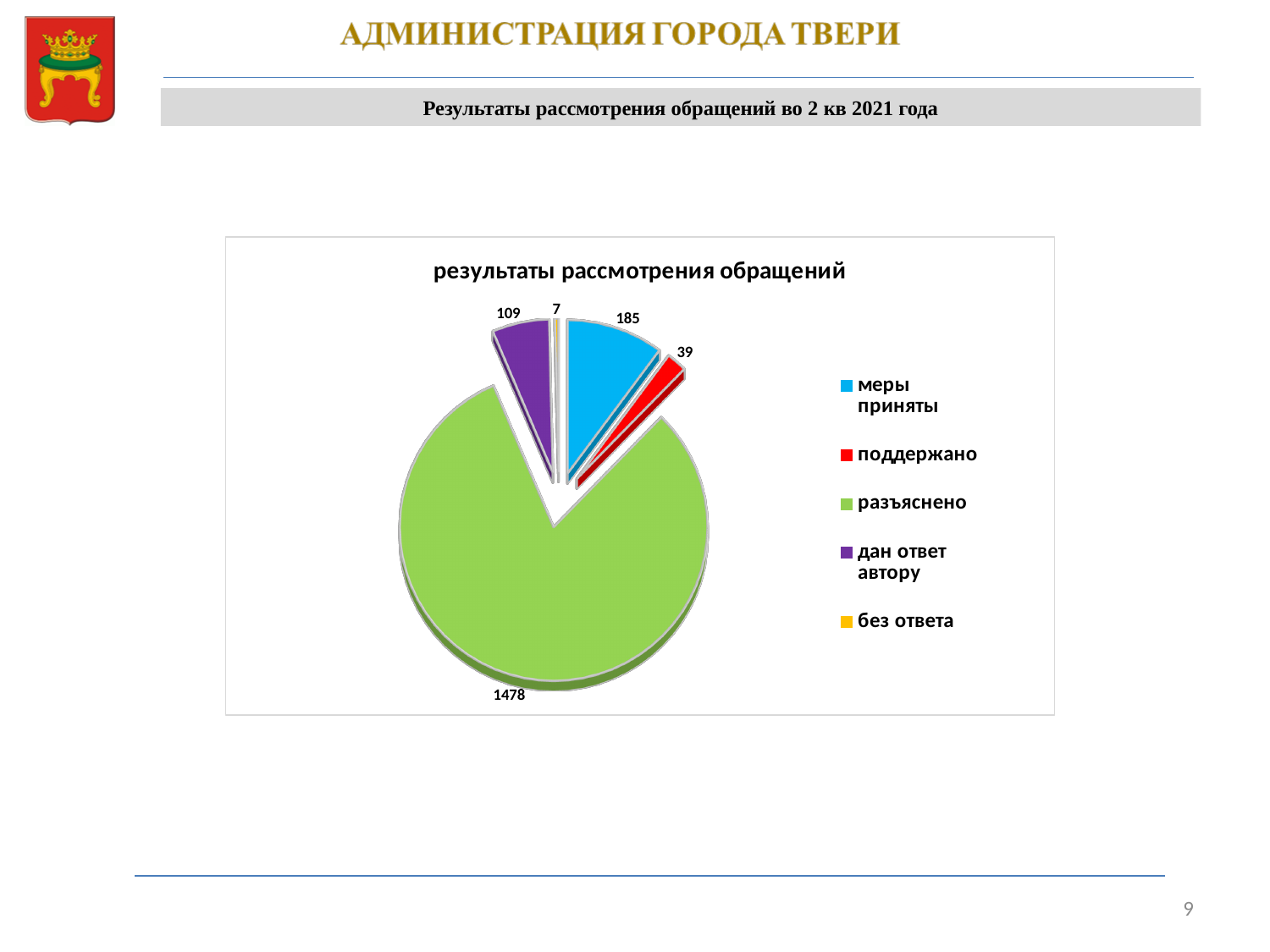
What is the value for без ответа? 7 Which category has the smallest slice? без ответа What is the value for дан ответ автору? 109 What is the value for разъяснено? 1478 What is the title of the chart? результаты рассмотрения обращений Which is larger, поддержано or дан ответ автору? дан ответ автору Which category has the largest slice? разъяснено How many categories does the legend list? 5 What is the difference between the values for меры приняты and дан ответ автору? 76 What kind of chart is shown on the slide? pie chart What is the value for меры приняты? 185 What is the value for поддержано? 39